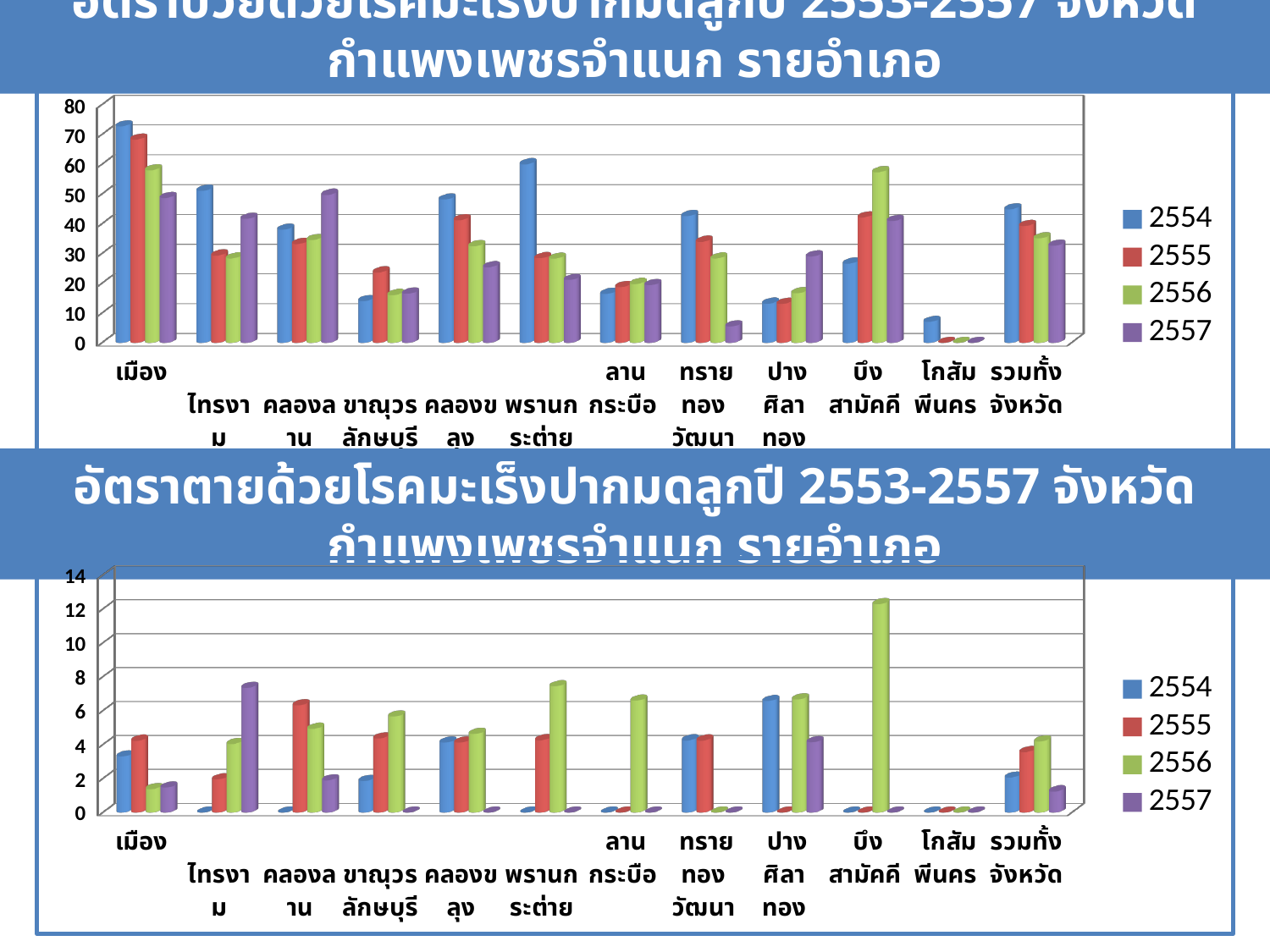
How many districts (categories) are shown along the x axis of the top chart? 12 What kind of chart is the top chart on the slide? bar chart In the top chart, which category has the lowest value for the 2554 series? โกสัมพีนคร In the bottom chart, which category has the highest value for the 2556 series? บึงสามัคคี In the bottom chart, which is larger for ไทรงาม: the 2555 value or the 2557 value? 2557 In the top chart, which category has the highest value for the 2554 series? เมือง How many series does the legend of the bottom chart list? 4 In the top chart, which is larger for บึงสามัคคี: the 2554 value or the 2556 value? 2556 In the top chart, is the 2554 value for พรานกระต่าย greater or less than 50? greater In the bottom chart, is the 2556 value for บึงสามัคคี greater or less than 10? greater In the top chart, is the 2554 value for ขาณุวรลักษบุรี greater or less than 20? less Which colour represents the 2556 series in the legend of the bottom chart? green